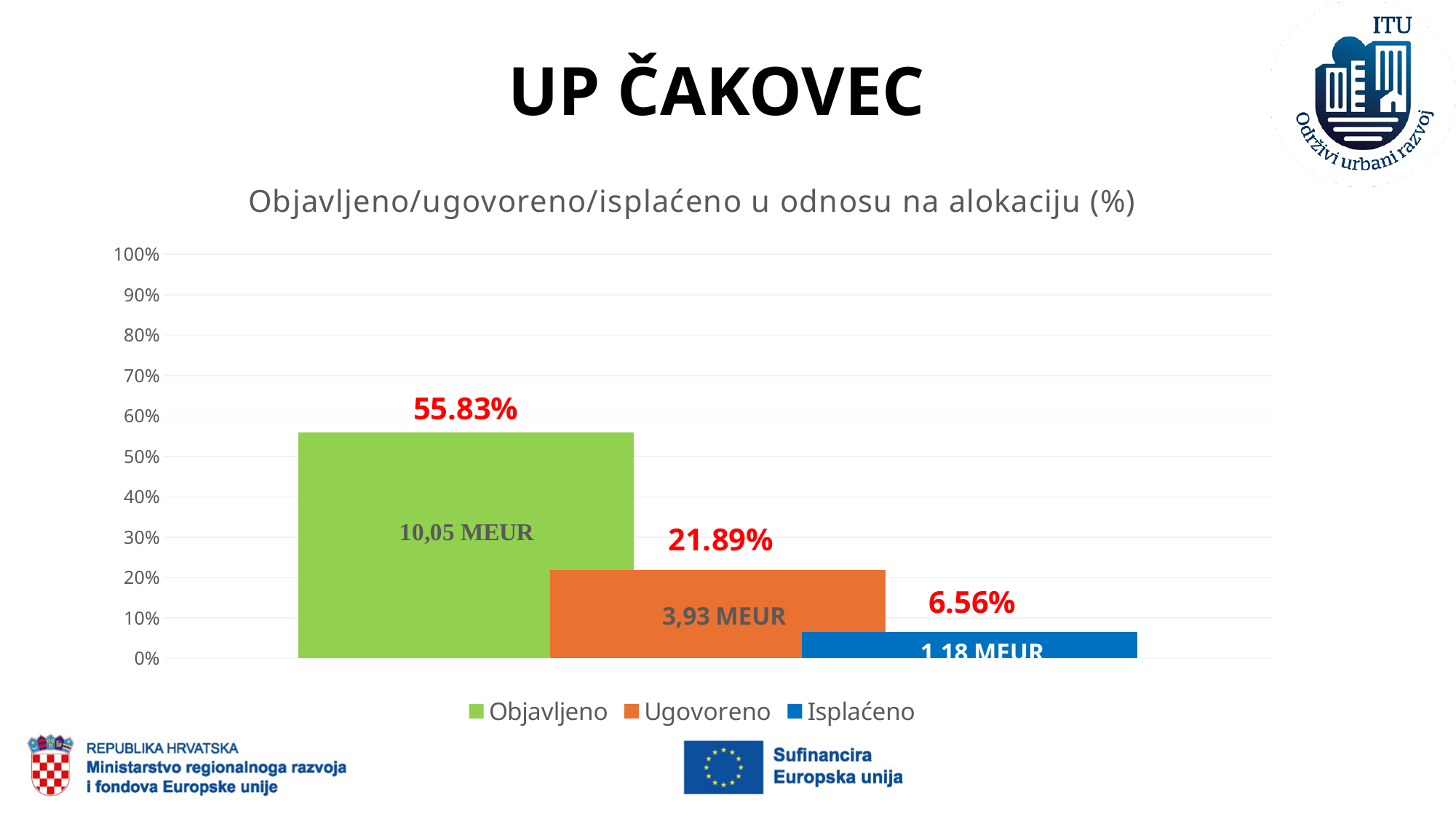
Which is larger, Ugovoreno or Isplaćeno? Ugovoreno Is the value for Objavljeno greater or less than 50%? greater What amount in MEUR is shown on the Ugovoreno bar? 3,93 MEUR Which series has the lowest value? Isplaćeno What type of chart is shown on the slide? bar chart What is the value for Objavljeno? 55.83% Which series has the highest value? Objavljeno What amount in MEUR is shown on the Objavljeno bar? 10,05 MEUR How many series does the legend list? 3 What is the difference between the Objavljeno and Ugovoreno percentages? 33.94% What is the value for Ugovoreno? 21.89% What is the value for Isplaćeno? 6.56%